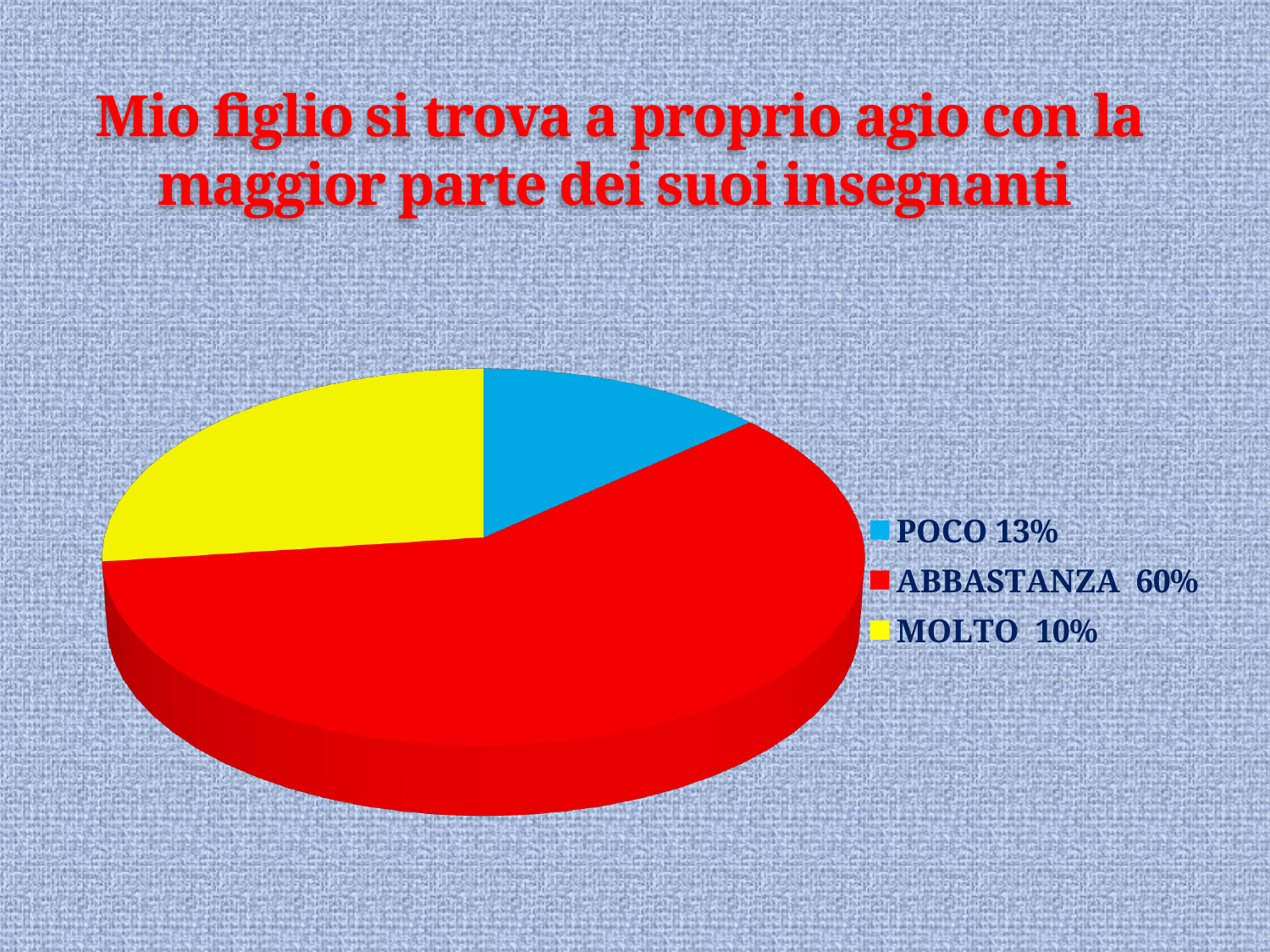
How many categories does the pie chart have? 3 What is the title of the slide? Mio figlio si trova a proprio agio con la maggior parte dei suoi insegnanti Which category has the largest slice of the pie? ABBASTANZA What percentage is shown for POCO? 13% What percentage is shown for MOLTO? 10% What is the difference in percentage points between ABBASTANZA and MOLTO? 50% What colour is the ABBASTANZA slice? red What percentage is shown for ABBASTANZA? 60% How many entries does the legend list? 3 What kind of chart is shown on the slide? pie chart What is the difference in percentage points between ABBASTANZA and POCO? 47% Which is larger, the share for ABBASTANZA or the share for POCO? ABBASTANZA